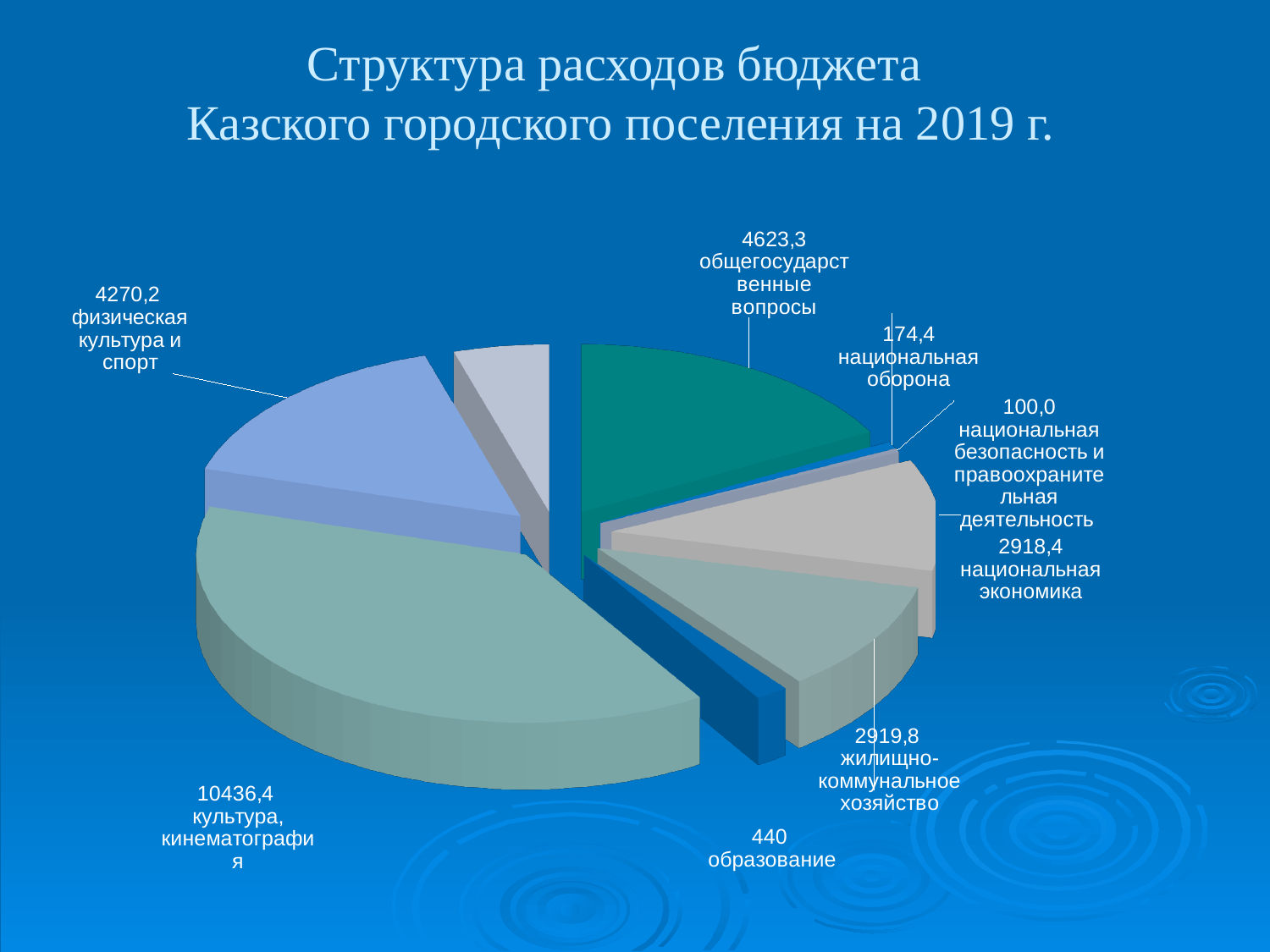
What is the value for культура, кинематография? 10436,4 Which category has the largest value? культура, кинематография What is the difference between the values for общегосударственные вопросы and физическая культура и спорт? 353,1 What is the value for образование? 440 Which labelled category has the smallest value? национальная безопасность и правоохранительная деятельность What is the value for жилищно-коммунальное хозяйство? 2919,8 What is the value for общегосударственные вопросы? 4623,3 Which is larger according to the labels: жилищно-коммунальное хозяйство or национальная экономика? жилищно-коммунальное хозяйство What kind of chart is shown on the slide? pie chart What is the title of the slide? Структура расходов бюджета Казского городского поселения на 2019 г. What is the difference between the values for национальная оборона and национальная безопасность и правоохранительная деятельность? 74,4 What is the value for национальная оборона? 174,4